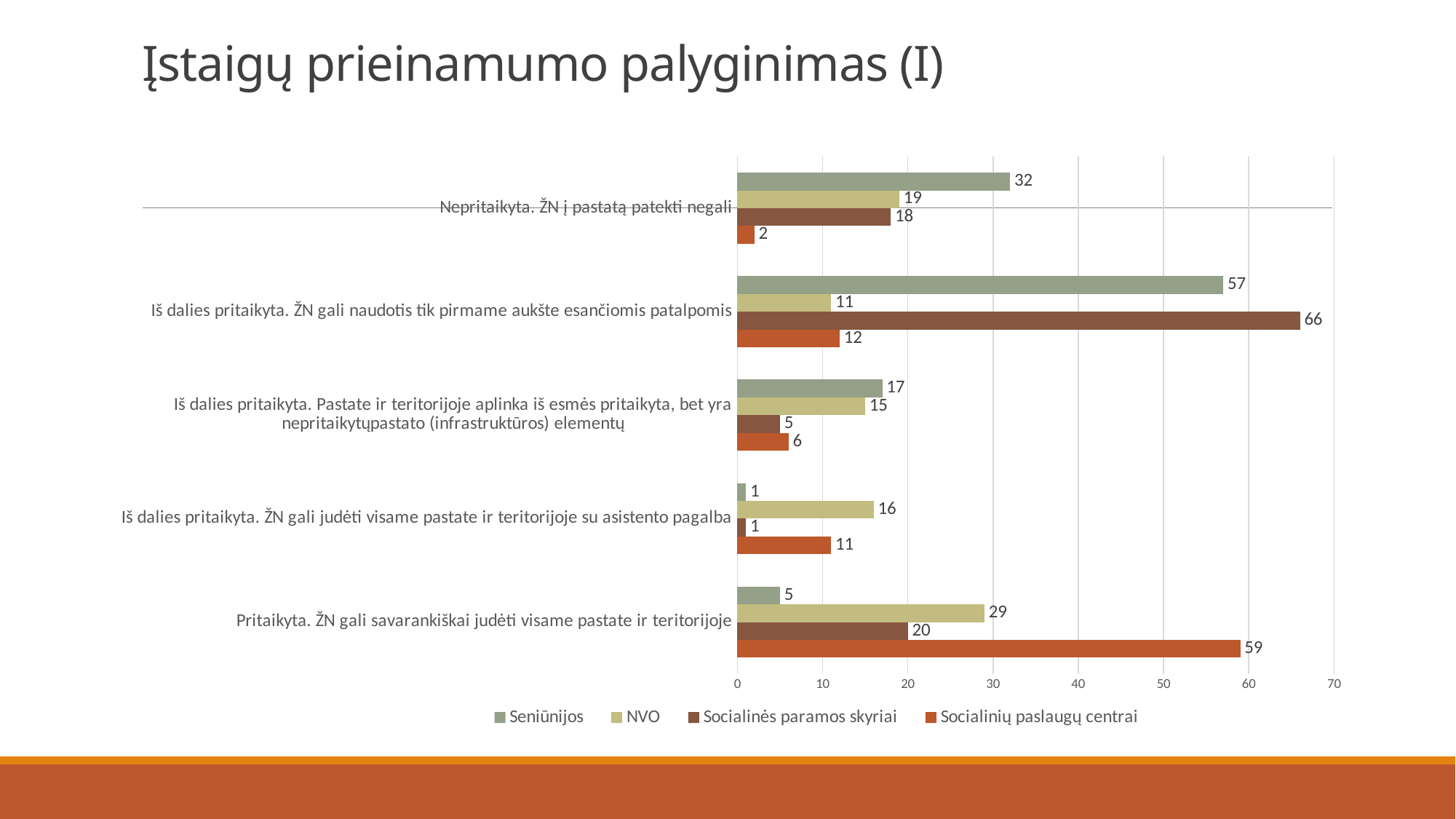
What is the title of the slide? Įstaigų prieinamumo palyginimas (I) How many categories are shown on the chart? 5 Which series has the highest value in the category "Iš dalies pritaikyta. ŽN gali naudotis tik pirmame aukšte esančiomis patalpomis"? Socialinės paramos skyriai What is the value for Seniūnijos in the category "Nepritaikyta. ŽN į pastatą patekti negali"? 32 What is the value for Socialinių paslaugų centrai in the category "Pritaikyta. ŽN gali savarankiškai judėti visame pastate ir teritorijoje"? 59 What is the difference between the Socialinės paramos skyriai value (66) and the Seniūnijos value (57) in the category "Iš dalies pritaikyta. ŽN gali naudotis tik pirmame aukšte esančiomis patalpomis"? 9 Which series has the lowest value in the category "Nepritaikyta. ŽN į pastatą patekti negali"? Socialinių paslaugų centrai In the category "Pritaikyta. ŽN gali savarankiškai judėti visame pastate ir teritorijoje", which is larger: the NVO value or the Socialinės paramos skyriai value? NVO Is the Socialinių paslaugų centrai value for "Pritaikyta. ŽN gali savarankiškai judėti visame pastate ir teritorijoje" greater or less than 50? greater How many series does the legend list? 4 What is the value for NVO in the category "Iš dalies pritaikyta. ŽN gali judėti visame pastate ir teritorijoje su asistento pagalba"? 16 What kind of chart is shown on the slide? bar chart